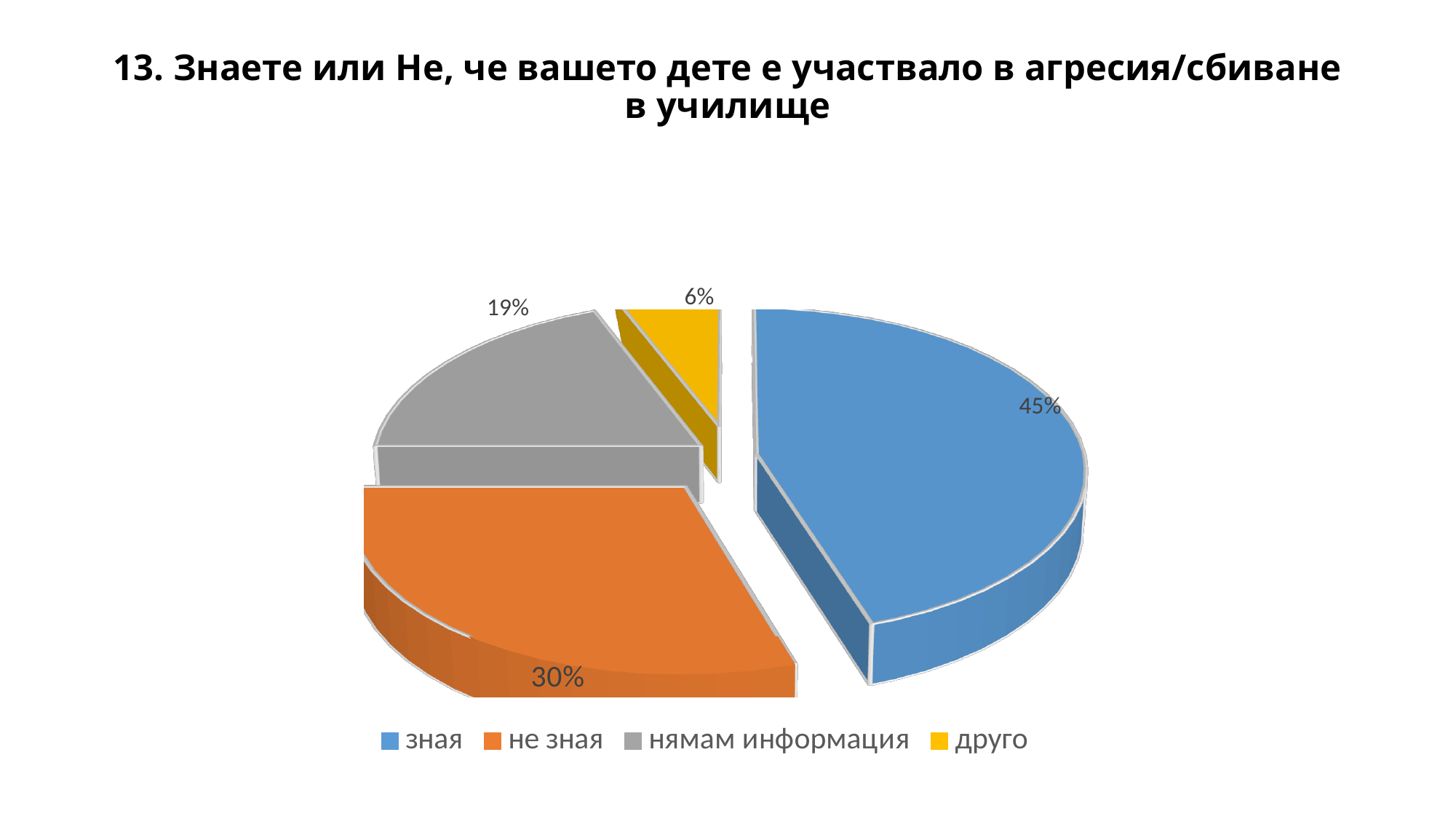
What share of the pie does the "нямам информация" slice represent? 19% How many categories are shown in the pie chart? 4 What share of the pie does the "друго" slice represent? 6% What colour is the "друго" slice in the pie chart? yellow Which category has the smallest slice of the pie? друго What share of the pie does the "зная" slice represent? 45% What is the difference in percentage points between the "зная" and "не зная" slices? 15 What kind of chart is shown on the slide? pie chart Which category has the largest slice of the pie? зная What is the difference in percentage points between the "нямам информация" and "друго" slices? 13 Which slice is larger, "не зная" or "нямам информация"? не зная